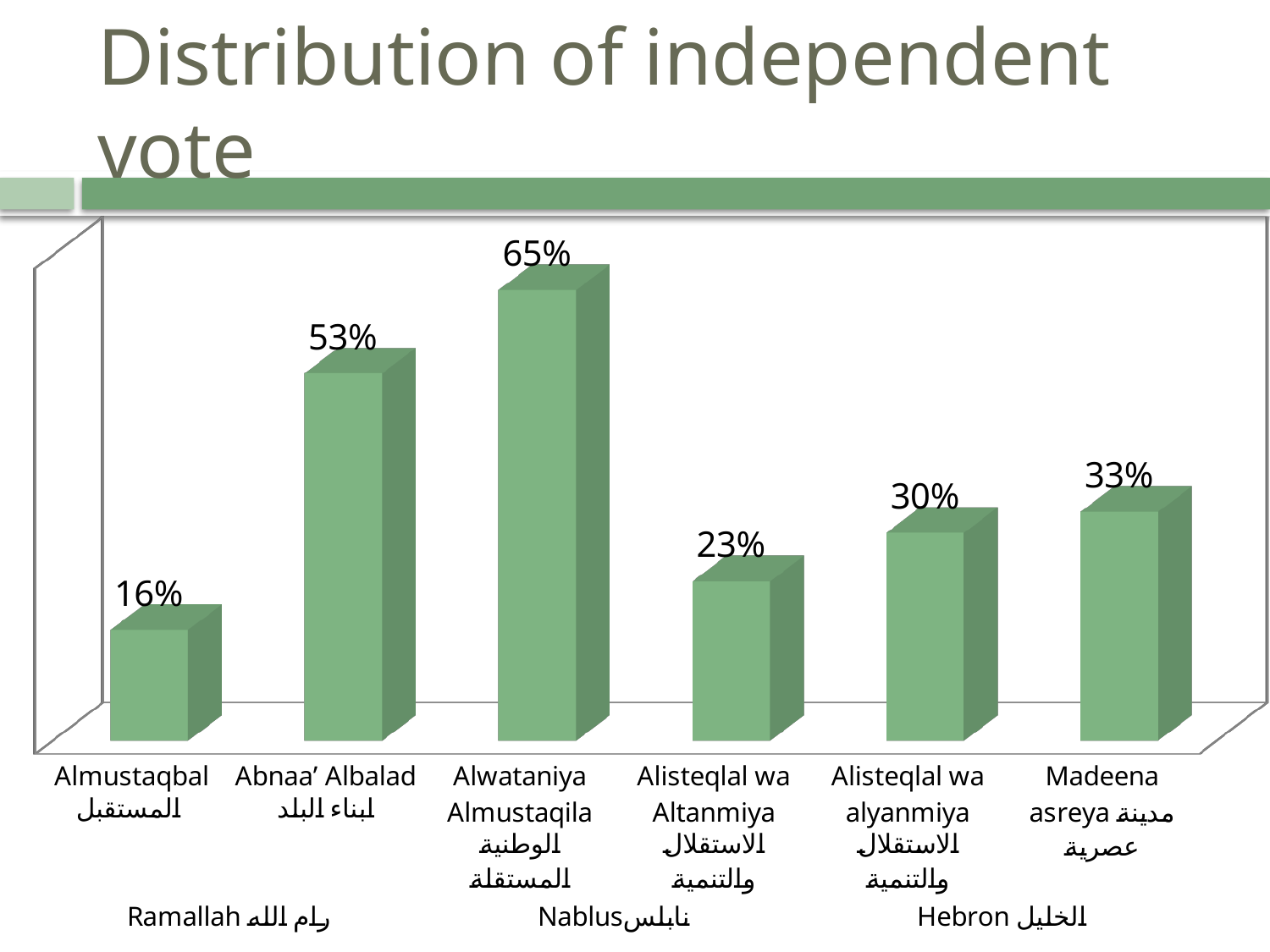
What is the value for Almustaqbal? 16% What is the title of the slide? Distribution of independent vote What is the value for Madeena asreya? 33% What is the value for Alwataniya Almustaqila? 65% How many categories are shown in the chart? 6 What is the difference between the values for Alwataniya Almustaqila and Madeena asreya? 32% Which three cities are labelled beneath the categories? Ramallah, Nablus, Hebron Which category has the highest value? Alwataniya Almustaqila Which is larger, the value for Alisteqlal wa alyanmiya or the value for Alisteqlal wa Altanmiya? Alisteqlal wa alyanmiya What is the difference between the values for Abnaa' Albalad and Almustaqbal? 37% What kind of chart is shown on the slide? Bar chart Which category has the lowest value? Almustaqbal